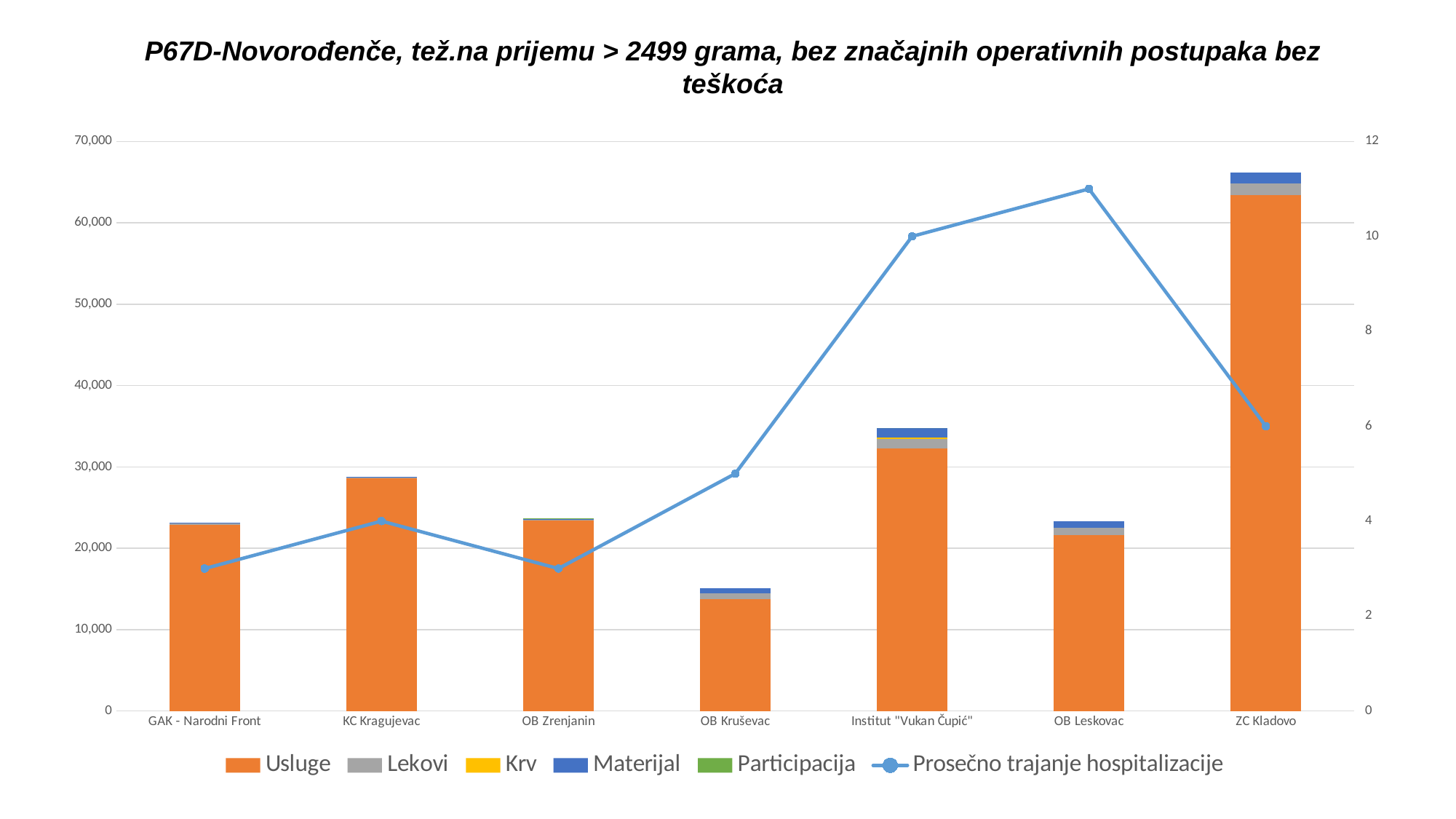
How many hospitals (categories) are shown on the x axis? 7 Which hospital has the lowest total stacked bar? OB Kruševac Is the total stacked bar for ZC Kladovo greater or less than 60,000? greater Is the total stacked bar for OB Kruševac greater or less than 20,000? less Is the 'Prosečno trajanje hospitalizacije' value for OB Leskovac greater or less than 10 on the right axis? greater How many series does the legend list? 6 Which series is shown in orange in the legend? Usluge Does the 'Prosečno trajanje hospitalizacije' line rise or fall from OB Zrenjanin to OB Leskovac? rise Which hospital has the highest total stacked bar? ZC Kladovo Which has the larger total stacked bar, Institut "Vukan Čupić" or KC Kragujevac? Institut "Vukan Čupić" Which hospital has the highest value on the 'Prosečno trajanje hospitalizacije' line? OB Leskovac What kind of chart is shown on the slide? Combined bar and line chart